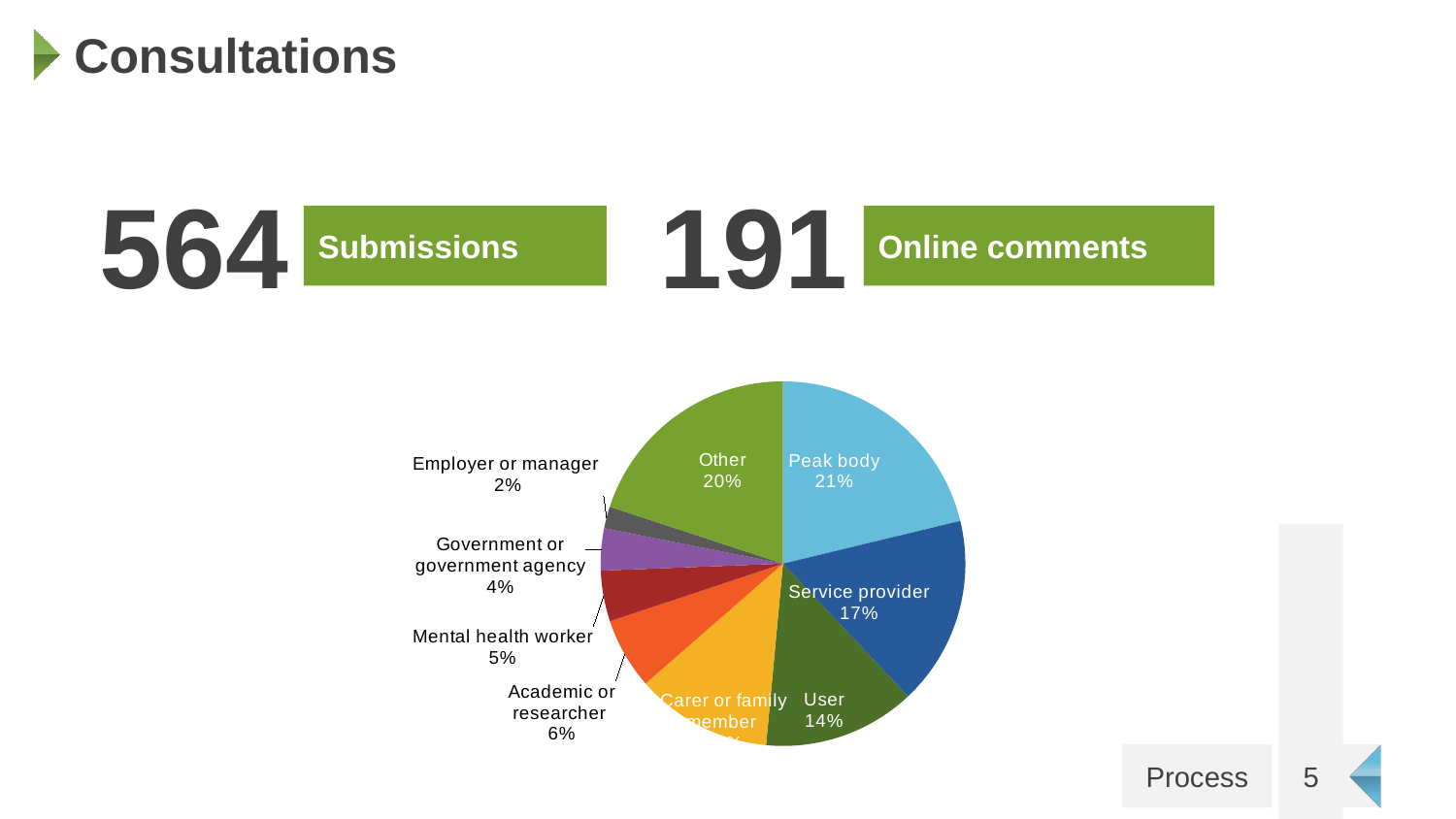
What percentage of the pie chart is Government or government agency? 4% Which is larger in the pie chart, Service provider or User? Service provider Which category has the largest share of the pie chart? Peak body What is the difference in percentage points between Academic or researcher and Employer or manager? 4 How many slices does the pie chart have? 9 What is the difference in percentage points between Peak body and Other? 1 What percentage of the pie chart is Peak body? 21% What kind of chart is shown on the slide? Pie chart What percentage of the pie chart is User? 14% What percentage of the pie chart is Mental health worker? 5% Which category has the smallest share of the pie chart? Employer or manager What percentage of the pie chart is Service provider? 17%